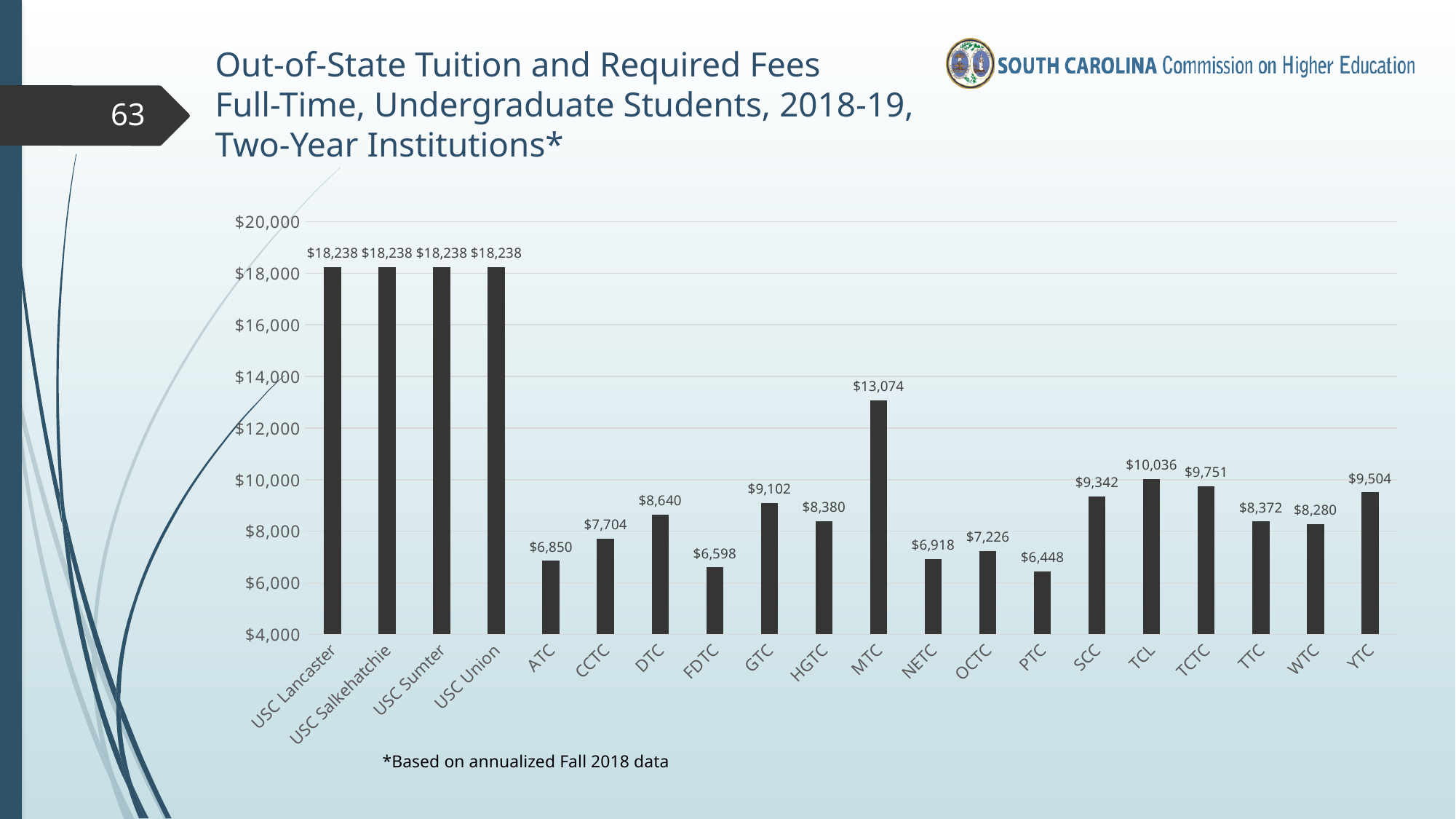
What is the value shown for PTC? $6,448 Is the value for MTC greater or less than $12,000? greater Which institution has the lowest out-of-state tuition and required fees? PTC Which is larger, the value for TCTC or the value for YTC? TCTC What is the difference between the values for USC Lancaster and PTC? $11,790 What is the out-of-state tuition and required fees value for MTC? $13,074 According to the footnote, what data is the chart based on? Annualized Fall 2018 data How many institutions are shown on the x axis? 20 What is the difference between the values for MTC and TCL? $3,038 What is the value shown for TCL? $10,036 What is the value shown for USC Sumter? $18,238 What kind of chart is shown on the slide? Bar chart